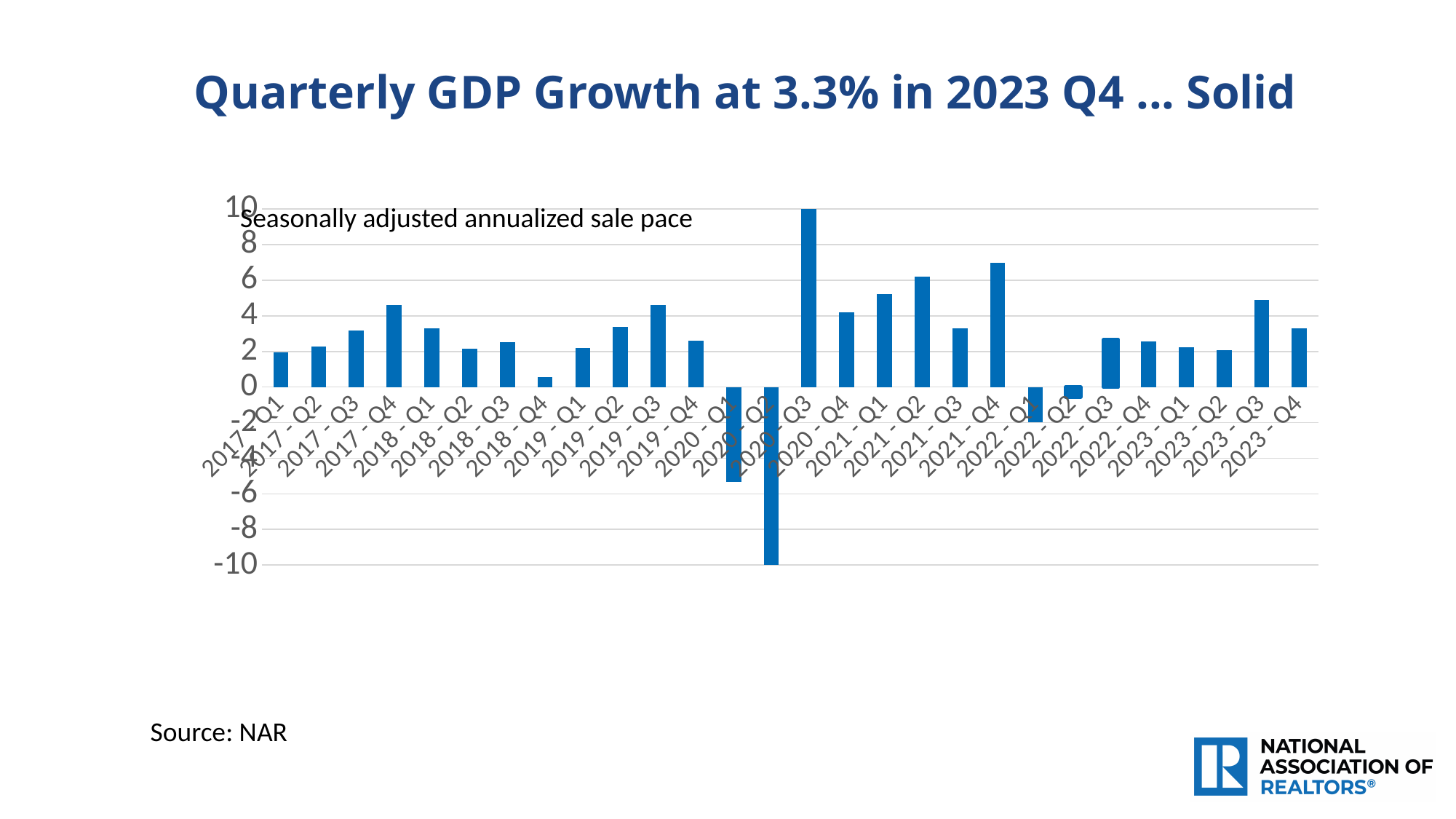
Which quarter has the highest GDP growth bar? 2020 - Q3 Is the value for 2020 - Q3 greater or less than 8? greater Is the value for 2022 - Q1 greater or less than 0? less What subtitle text appears inside the chart area? Seasonally adjusted annualized sale pace According to the slide title, what was quarterly GDP growth in 2023 Q4? 3.3% Is the value for 2018 - Q4 greater or less than 2? less Which quarter has the lowest GDP growth bar? 2020 - Q2 What kind of chart is shown on the slide? bar chart Which is larger, the value for 2021 - Q2 or the value for 2021 - Q1? 2021 - Q2 How many quarterly bars are plotted on the chart? 28